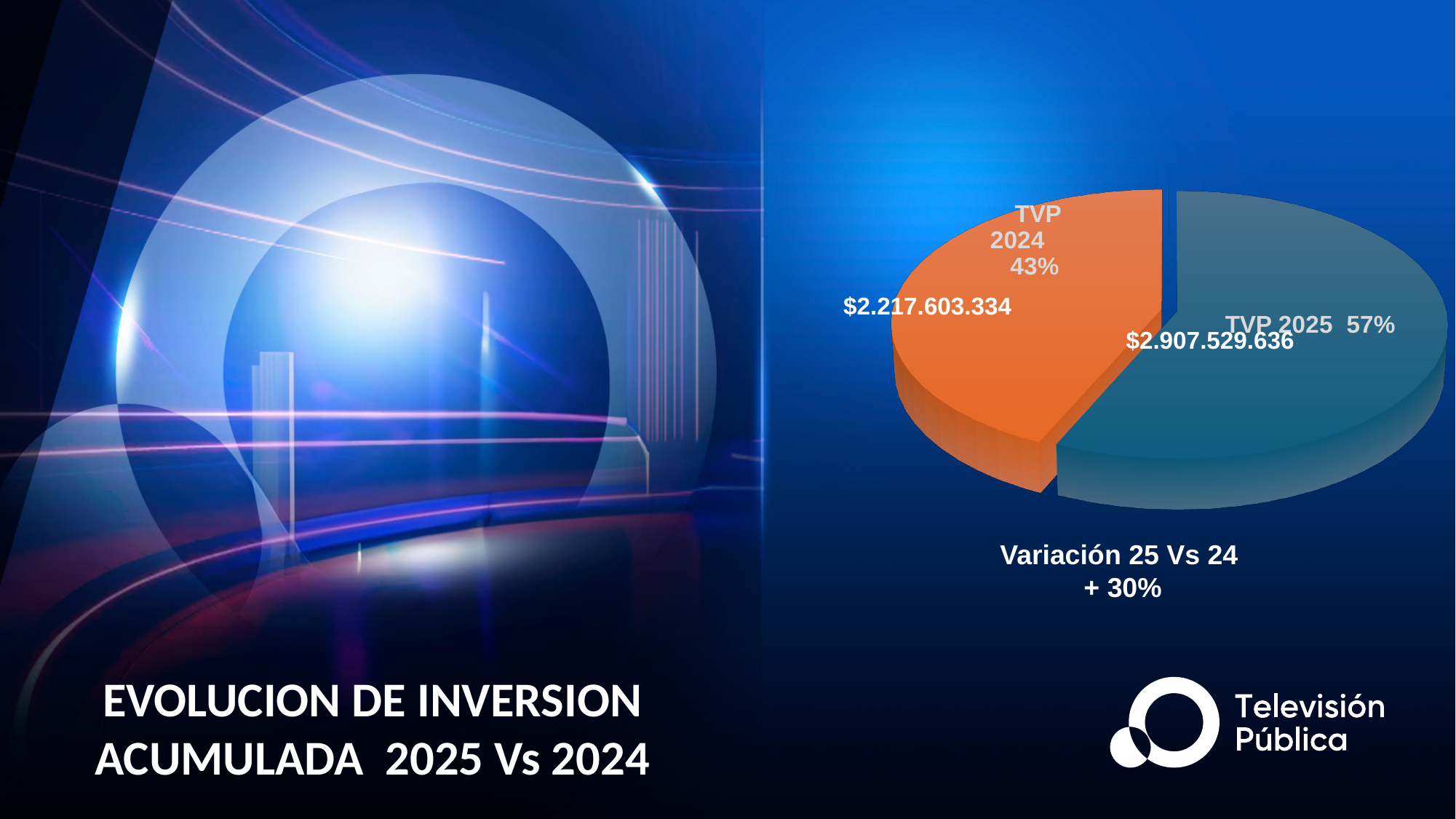
Which slice is larger, TVP 2024 or TVP 2025? TVP 2025 What share of the pie does TVP 2025 represent? 57% What variation between 2025 and 2024 is stated below the pie chart? + 30% What is the difference in percentage points between the TVP 2025 and TVP 2024 shares? 14 percentage points What kind of chart is shown on the slide? pie chart Which category has the largest slice of the pie? TVP 2025 How many slices does the pie chart have? 2 What is the value shown for TVP 2025? $2.907.529.636 What colour is the TVP 2024 slice of the pie chart? orange What share of the pie does TVP 2024 represent? 43% Which category has the smallest slice of the pie? TVP 2024 What is the value shown for TVP 2024? $2.217.603.334